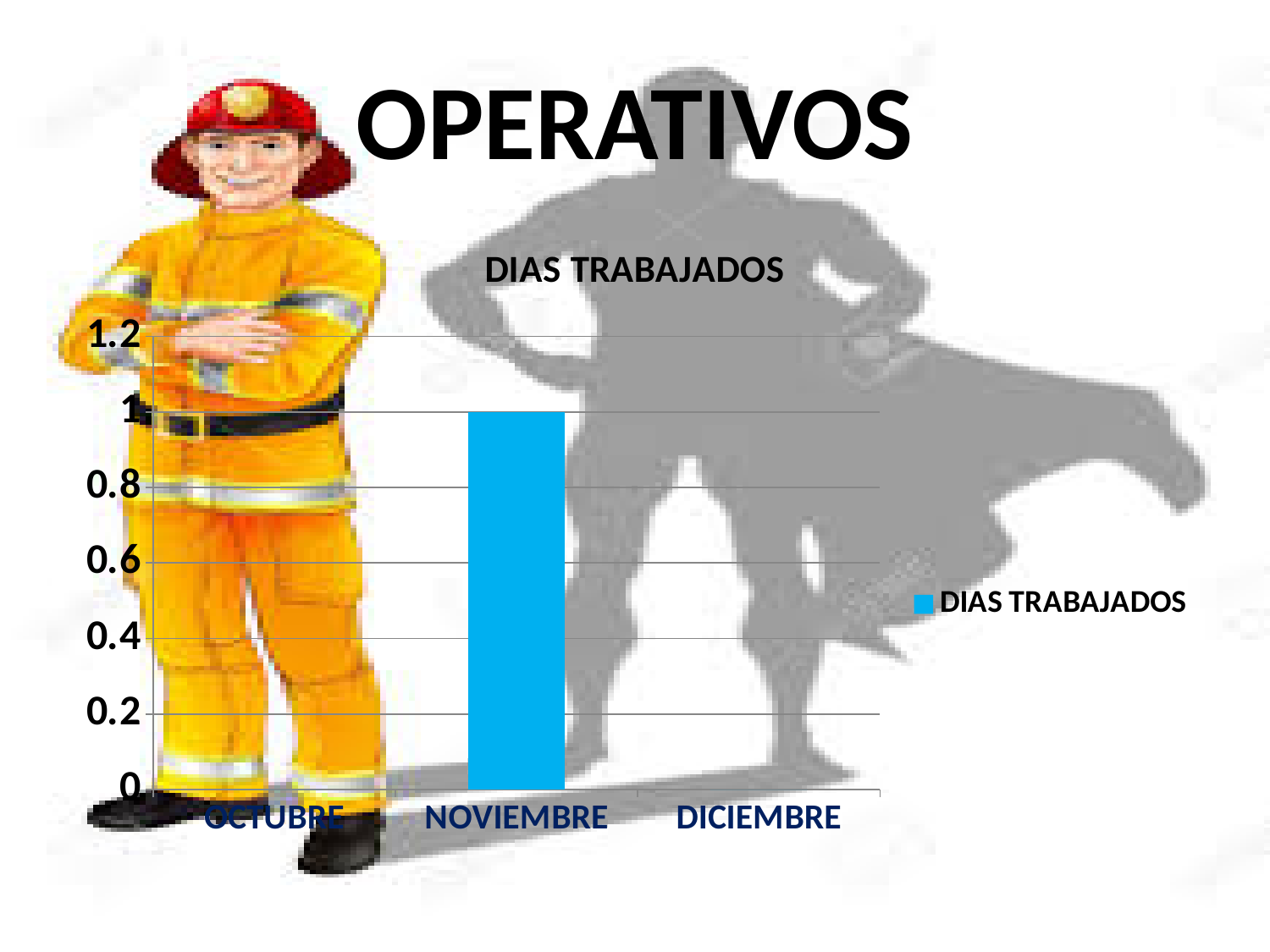
How many series does the chart legend list? 1 Which is larger, the value for NOVIEMBRE or the value for DICIEMBRE? NOVIEMBRE Which category is listed last on the x axis of the chart? DICIEMBRE What kind of chart is shown on the slide? bar chart What is the title of the chart? DIAS TRABAJADOS Is the value for NOVIEMBRE greater or less than 1.2? less How many categories are shown on the x axis of the chart? 3 What is the highest tick value shown on the y axis of the chart? 1.2 What is the value for NOVIEMBRE in the chart? 1 Is the value for NOVIEMBRE greater or less than 0.8? greater